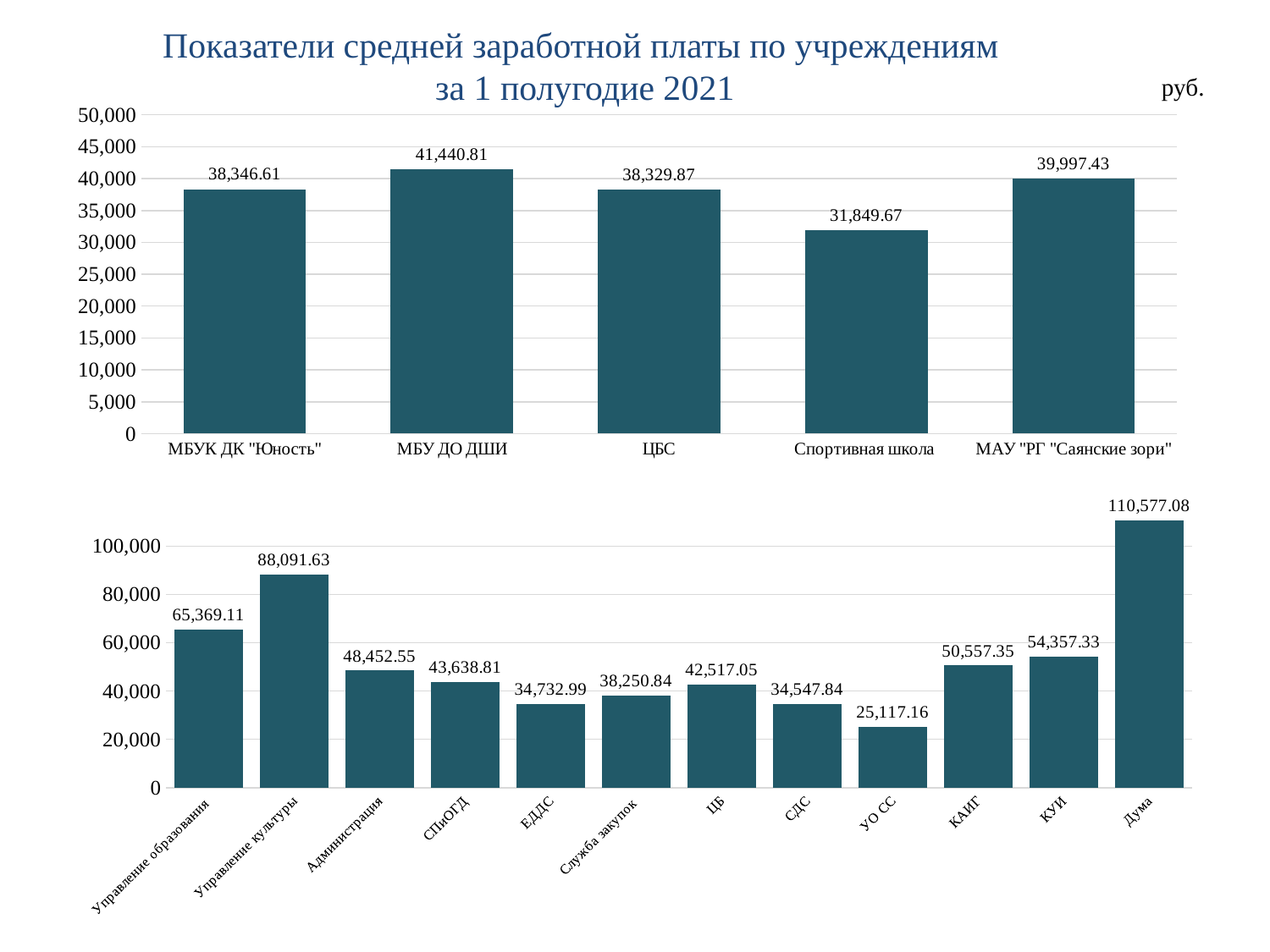
In the top chart, what is the difference between the values for МБУ ДО ДШИ and Спортивная школа? 9,591.14 In the top chart, which institution has the lowest average salary? Спортивная школа How many categories are shown in the bottom chart? 12 How many institutions are shown in the top chart? 5 In the bottom chart, which category has the highest value? Дума In the top chart, which institution has the highest average salary? МБУ ДО ДШИ In the bottom chart, which category has the lowest value? УО СС In the top chart, what is the average salary for МБУ ДО ДШИ? 41,440.81 What type of chart is the top chart? Bar chart In the bottom chart, which is larger: the value for КУИ or the value for КАИГ? КУИ In the bottom chart, what is the difference between the values for Управление культуры and Управление образования? 22,722.52 In the bottom chart, what is the value for Дума? 110,577.08